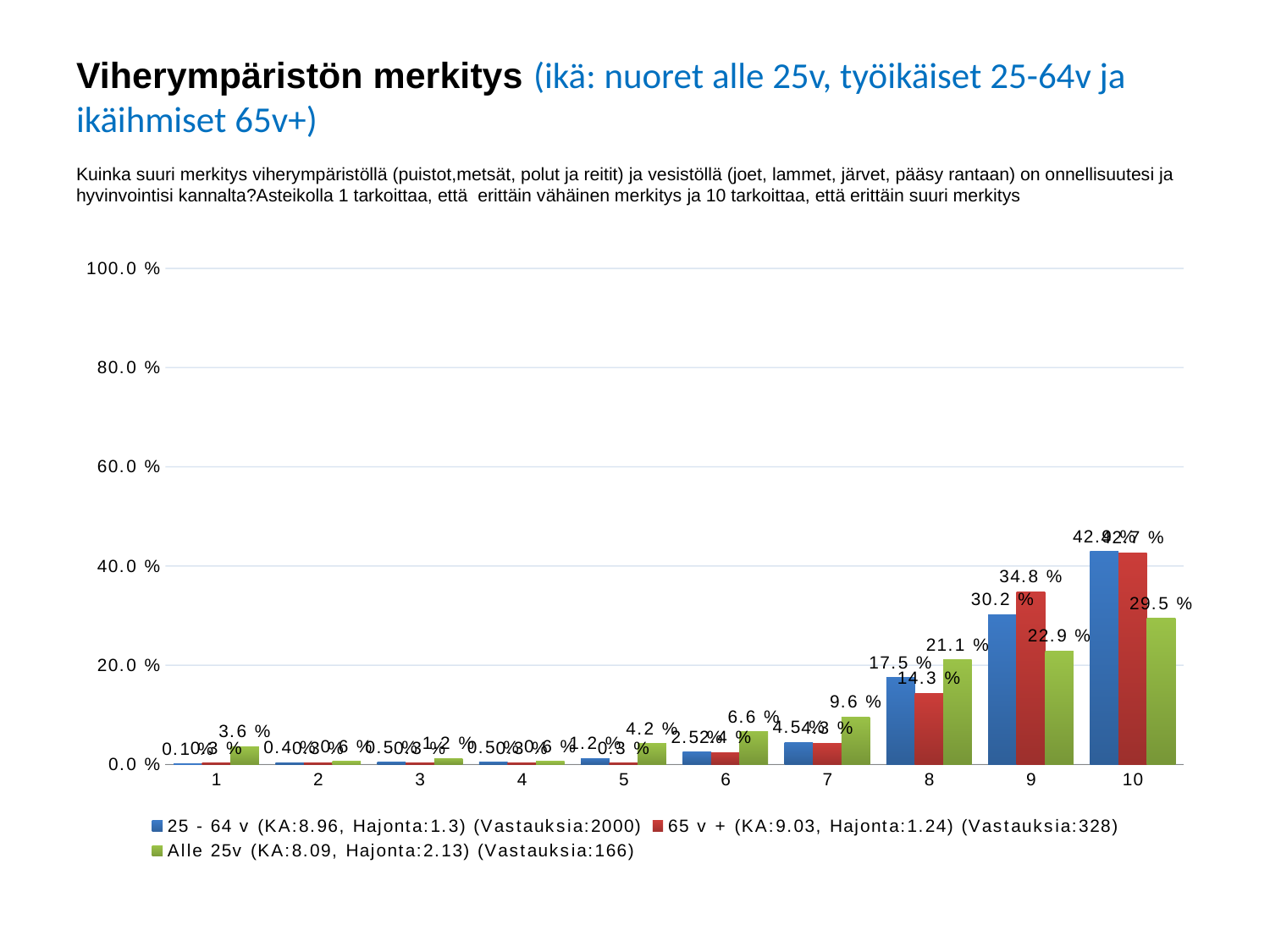
What is the value for the '65 v +' series at category 9? 34.8 % Do the values for the '65 v +' series generally rise or fall from category 1 to category 10? rise Which category has the highest value for the 'Alle 25v' series? 10 What is the value for the '25 - 64 v' series at category 8? 17.5 % How many series does the legend list? 3 How many categories are shown on the x axis? 10 What is the difference between the '65 v +' and '25 - 64 v' values at category 9? 4.6 % At category 8, which series has the larger value: 'Alle 25v' or '25 - 64 v'? Alle 25v What kind of chart is shown on the slide? bar chart Is the value for the '25 - 64 v' series at category 10 greater or less than 40.0 %? greater What is the value for the 'Alle 25v' series at category 10? 29.5 % What is the value for the 'Alle 25v' series at category 9? 22.9 %